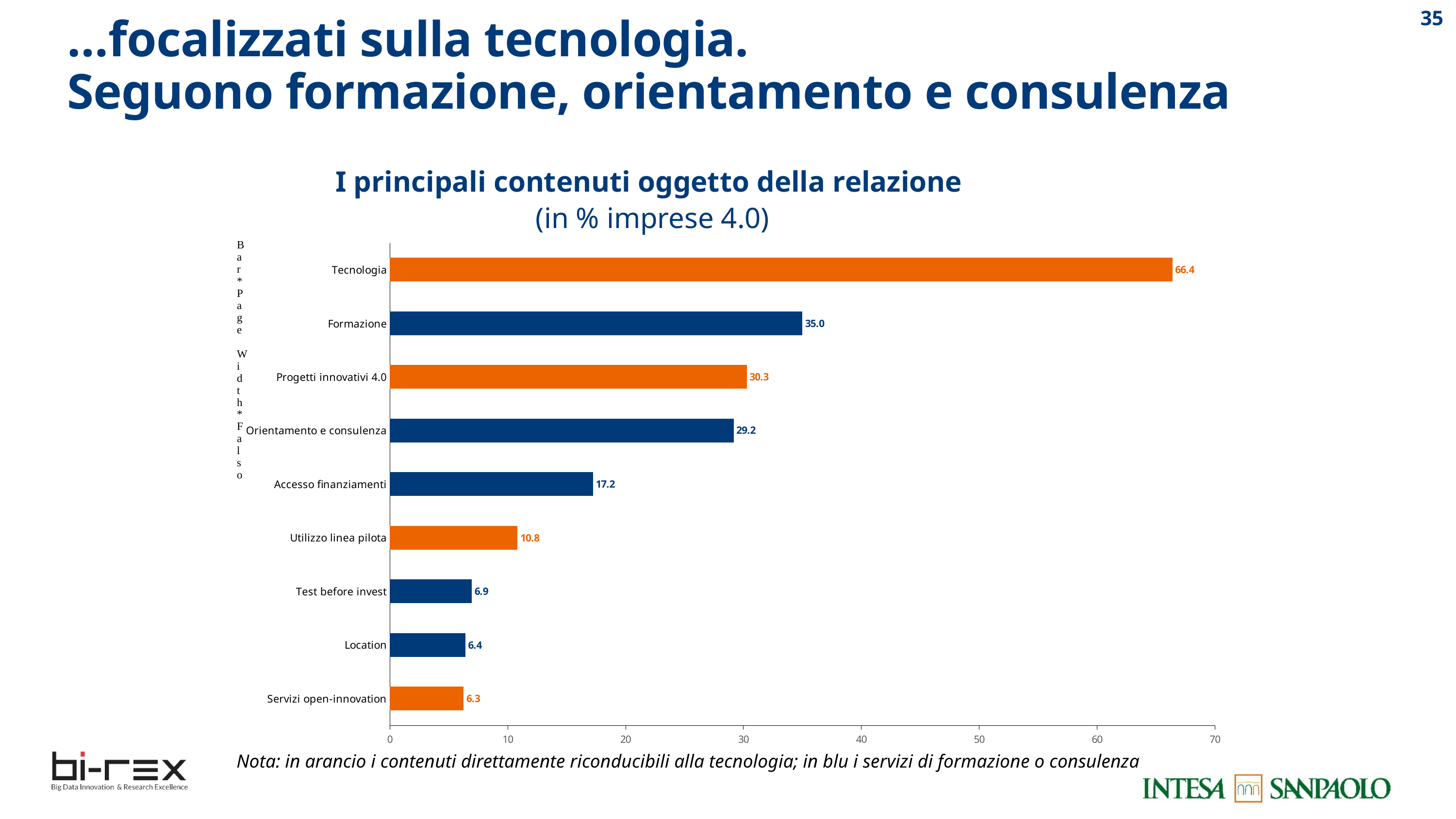
What is the value for Accesso finanziamenti? 17.2 What is the difference between the values for Progetti innovativi 4.0 and Orientamento e consulenza? 1.1 What is the title of the chart? I principali contenuti oggetto della relazione Which category has the highest value? Tecnologia What is the value for Tecnologia? 66.4 How many categories are shown in the chart? 9 What is the difference between the values for Tecnologia and Formazione? 31.4 What is the value for Utilizzo linea pilota? 10.8 What kind of chart is shown on the slide? Bar chart What is the value for Formazione? 35.0 Which is larger, the value for Formazione or the value for Progetti innovativi 4.0? Formazione Which category has the lowest value? Servizi open-innovation